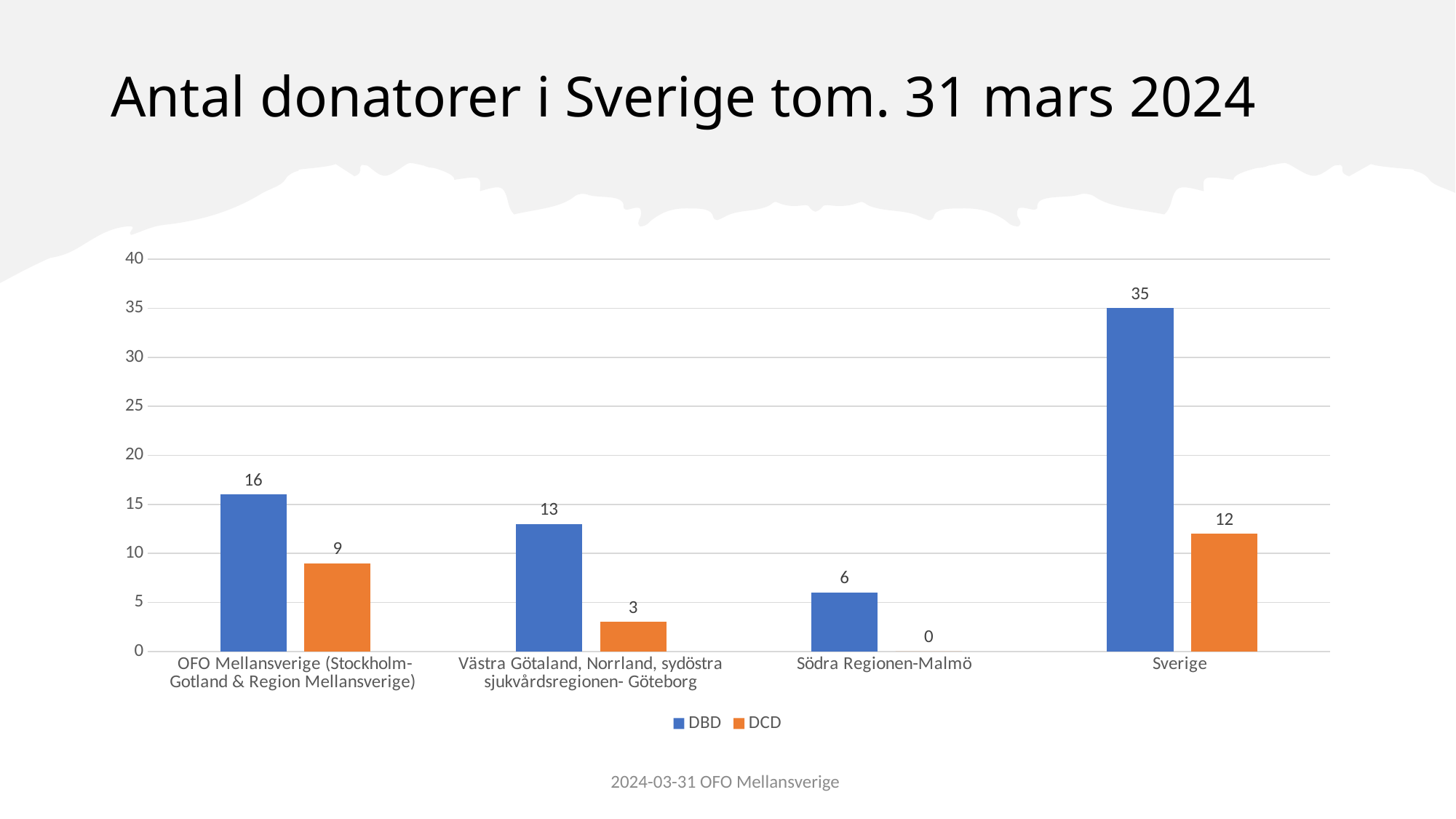
Which category has the lowest DCD value? Södra Regionen-Malmö What is the difference between the DBD and DCD values for Sverige? 23 How many categories are shown on the x axis? 4 What is the DCD value for OFO Mellansverige (Stockholm-Gotland & Region Mellansverige)? 9 How many series does the legend list? 2 What is the DBD value for Västra Götaland, Norrland, sydöstra sjukvårdsregionen- Göteborg? 13 What kind of chart is shown on the slide? Bar chart What is the difference between the DBD values for OFO Mellansverige and Södra Regionen-Malmö? 10 What is the DCD value for Södra Regionen-Malmö? 0 What is the DBD value for Sverige? 35 Which category has the highest DBD value? Sverige Which is larger, the DCD value for OFO Mellansverige or the DCD value for Västra Götaland, Norrland, sydöstra sjukvårdsregionen- Göteborg? OFO Mellansverige